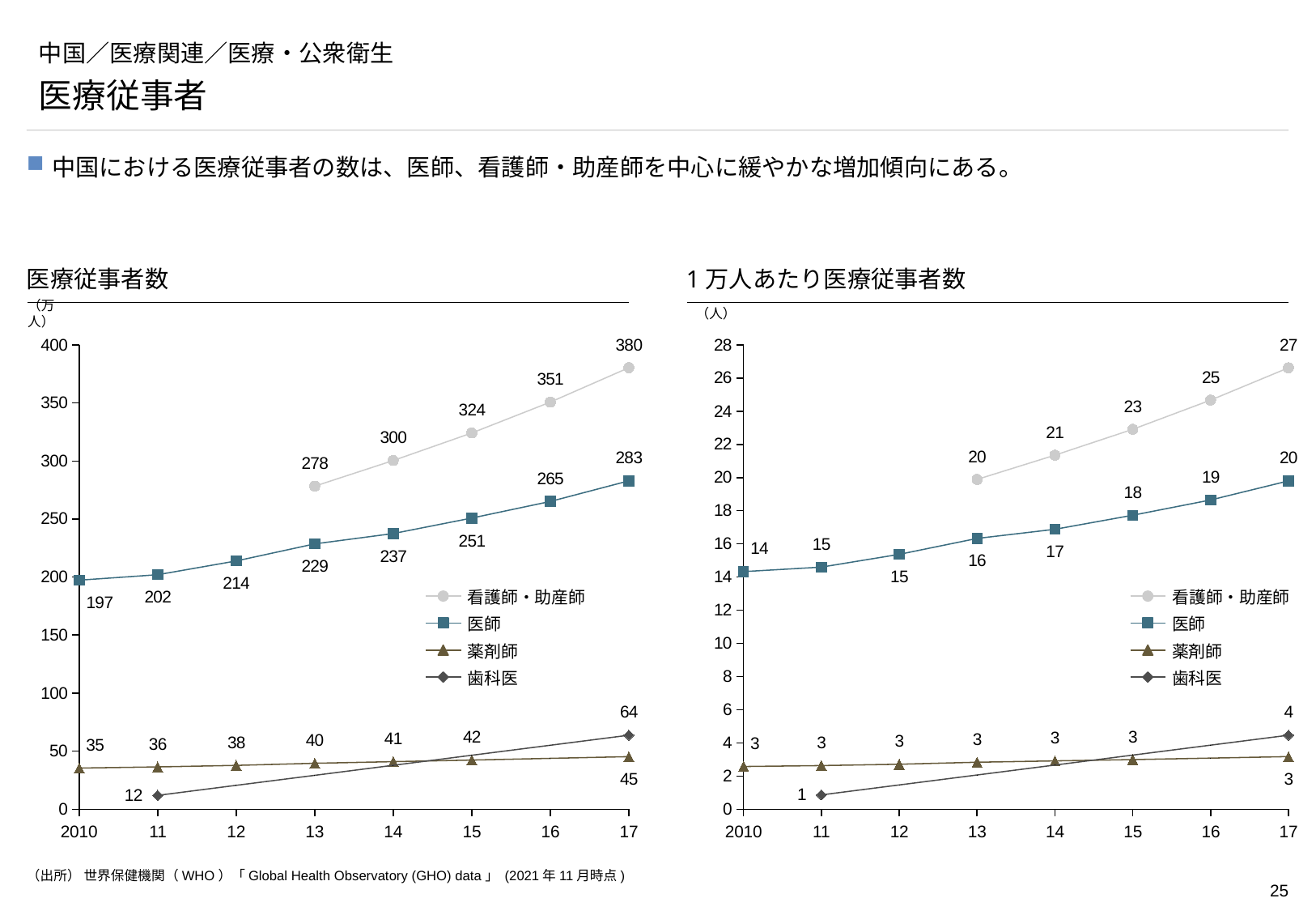
In the 医療従事者数 chart on the left, does the 医師 series rise or fall from 2010 to 2017? rise In the 医療従事者数 chart on the left, which series has the highest value in 2017? 看護師・助産師 In the 医療従事者数 chart on the left, what is the value for 歯科医 in 2017? 64 In the 1万人あたり医療従事者数 chart on the right, what is the value for 歯科医 in 2011? 1 How many series does the legend list in the 1万人あたり医療従事者数 chart on the right? 4 In the 医療従事者数 chart on the left, what is the value for 看護師・助産師 in 2017? 380 What type of chart is the 医療従事者数 chart on the left? line chart In the 1万人あたり医療従事者数 chart on the right, which is larger in 2017, 医師 or 薬剤師? 医師 In the 1万人あたり医療従事者数 chart on the right, what is the value for 看護師・助産師 in 2013? 20 In the 医療従事者数 chart on the left, by how much did 医師 increase from 2010 to 2017? 86 In the 医療従事者数 chart on the left, what is the value for 医師 in 2010? 197 In the 医療従事者数 chart on the left, is the value for 薬剤師 in 2016 greater or less than 50? less